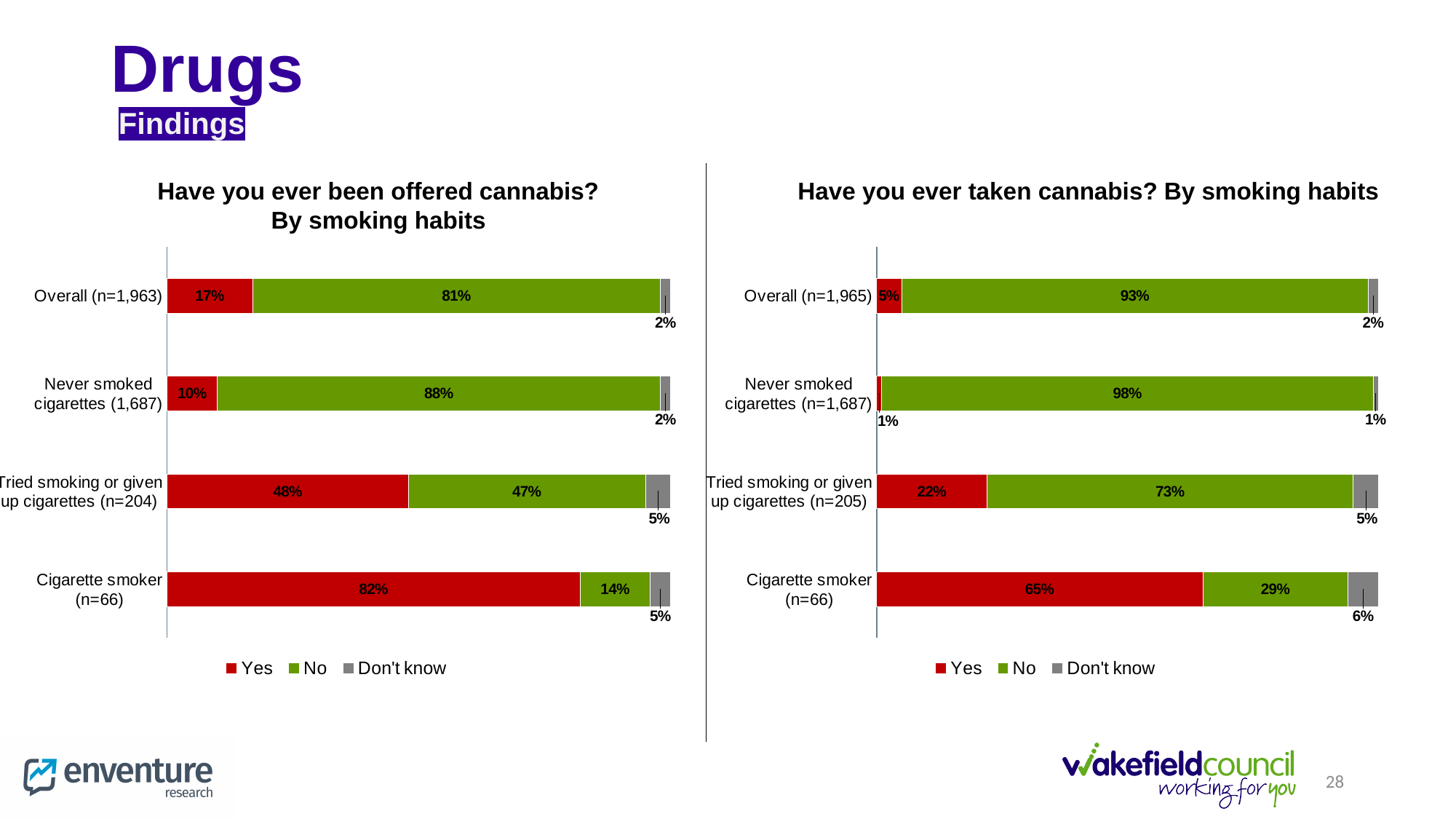
In the 'Have you ever been offered cannabis?' chart, what percentage of cigarette smokers answered Yes? 82% In the 'Have you ever been offered cannabis?' chart, which smoking-habit group has the highest Yes percentage? Cigarette smoker (n=66) How many smoking-habit categories are shown in the 'Have you ever been offered cannabis?' chart? 4 In the 'Have you ever taken cannabis?' chart, which smoking-habit group has the lowest Yes percentage? Never smoked cigarettes (n=1,687) In the 'Have you ever been offered cannabis?' chart, what is the Overall percentage answering Yes? 17% In the 'Have you ever taken cannabis?' chart, which is larger for cigarette smokers: the Yes percentage or the No percentage? Yes In the 'Have you ever been offered cannabis?' chart, what is the difference between the Yes percentage for cigarette smokers and the Yes percentage for those who never smoked cigarettes? 72 percentage points In the 'Have you ever taken cannabis?' chart, what is the Don't know percentage for cigarette smokers? 6% What kind of chart is the 'Have you ever been offered cannabis?' chart? Stacked bar chart How many series does the legend of the 'Have you ever taken cannabis?' chart list? 3 In the 'Have you ever taken cannabis?' chart, what percentage of those who tried smoking or given up cigarettes answered Yes? 22% In the 'Have you ever taken cannabis?' chart, what percentage of those who never smoked cigarettes answered No? 98%